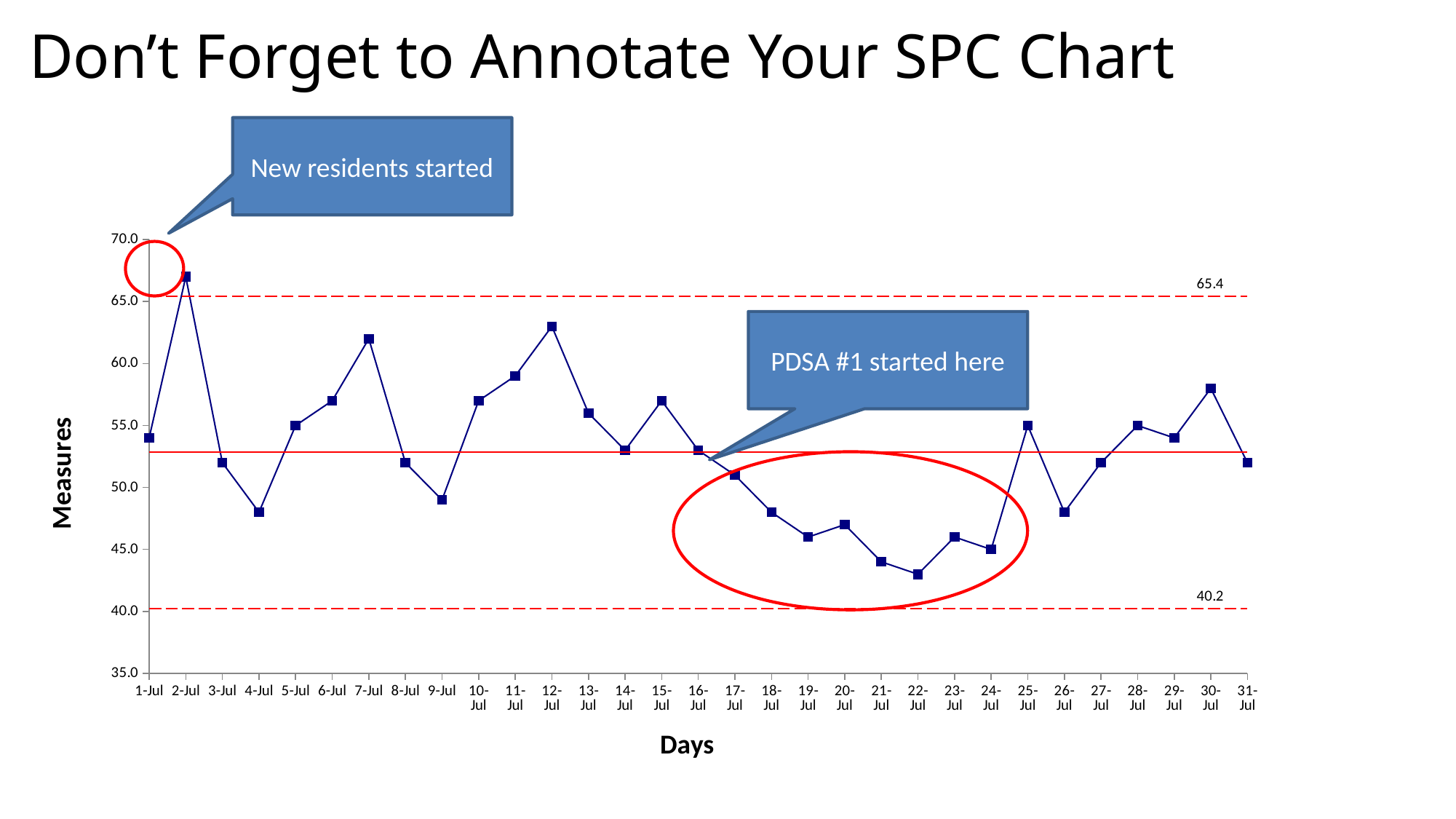
Which day has the highest plotted value? 2-Jul How many data points are plotted on the chart? 31 Do the plotted values rise or fall from 17-Jul to 22-Jul? fall Is the value for 4-Jul greater or less than 50.0? less Which day has the larger value, 12-Jul or 13-Jul? 12-Jul Which day has the lowest plotted value? 22-Jul Is the value for 2-Jul greater or less than 65.0? greater What is the title of the x axis? Days What kind of chart is shown on the slide? line chart Is the value for 7-Jul greater or less than 60.0? greater What value is labelled on the upper dashed control limit line? 65.4 What value is labelled on the lower dashed control limit line? 40.2